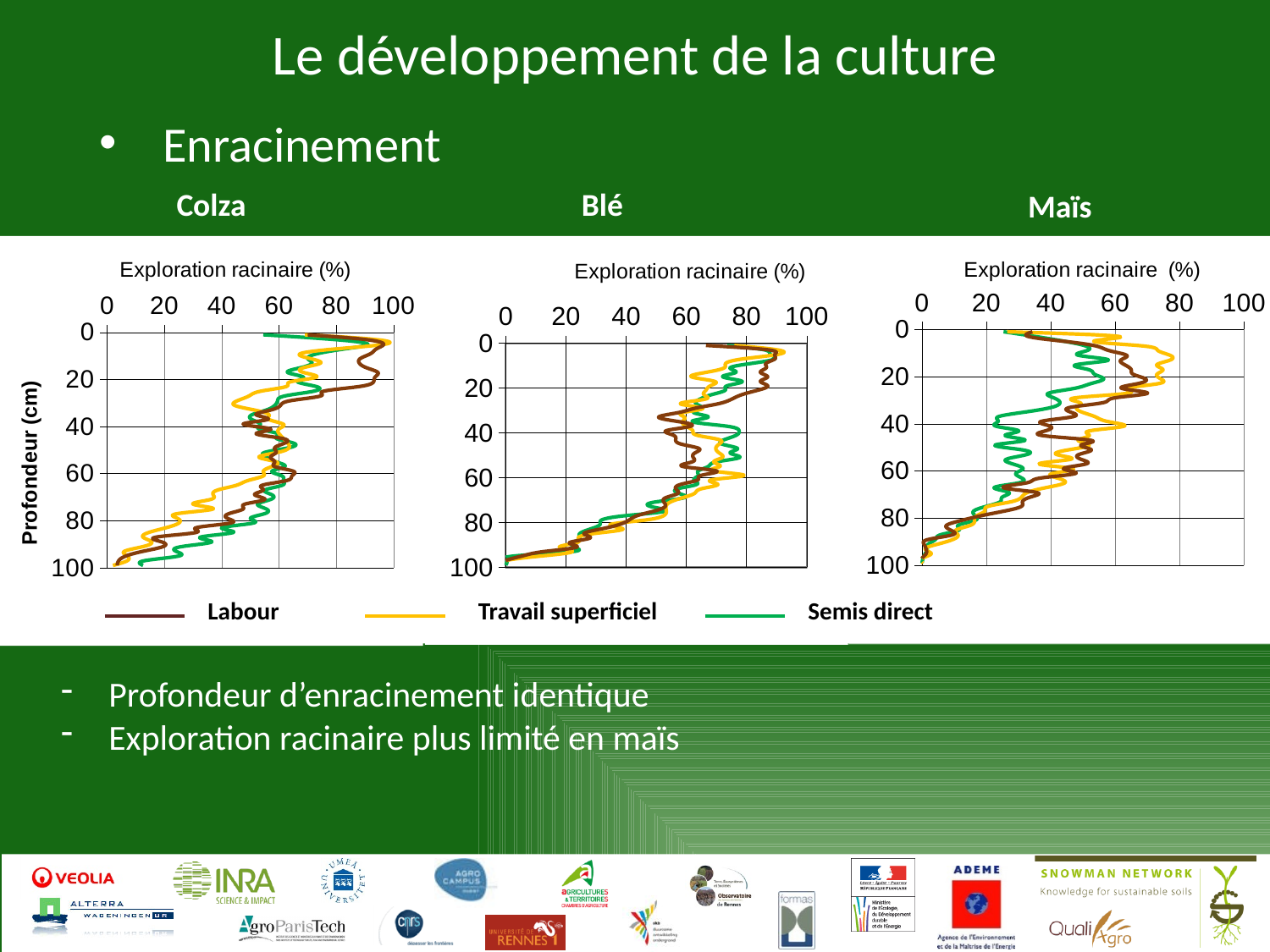
How many charts are shown on the slide? 3 In the Colza chart, is the Travail superficiel value at a depth of 100 cm greater or less than 20? less In the Maïs chart, at a depth of 20 cm, which is larger: the Travail superficiel value or the Semis direct value? Travail superficiel What kind of chart is used for the Colza, Blé and Maïs panels? line chart What are the three series named in the legend? Labour, Travail superficiel, Semis direct In the Maïs chart, is the Travail superficiel value at a depth of 20 cm greater or less than 60? greater In the Blé chart, does root exploration generally rise or fall as depth increases from 0 to 100 cm? fall In the Colza chart, is the Labour value at a depth of 20 cm greater or less than 80? greater How many series does the shared legend list? 3 What is the label of the horizontal axis on the Colza chart? Exploration racinaire (%)